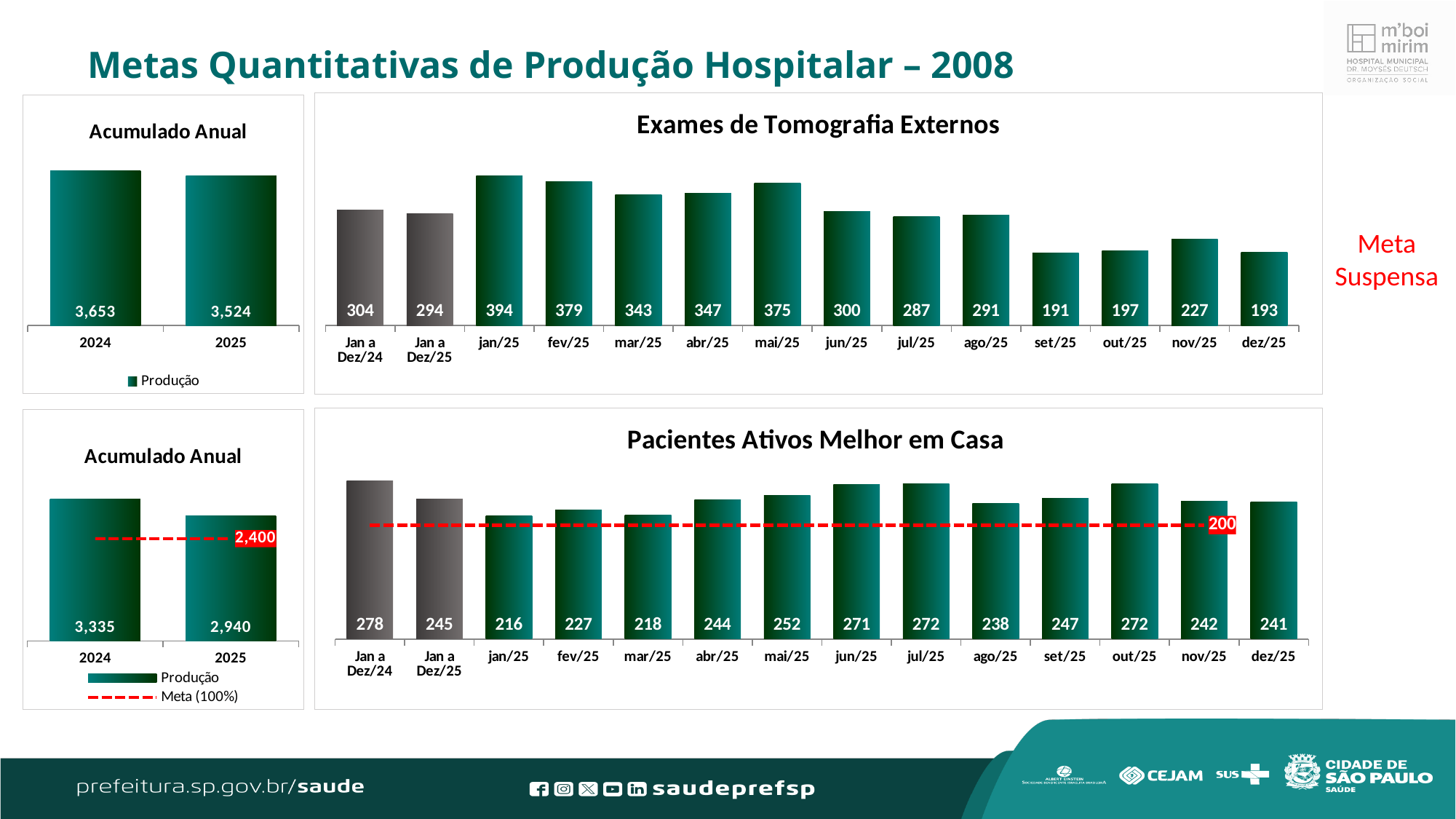
In the 'Pacientes Ativos Melhor em Casa' chart, which month of 2025 has the lowest value? jan/25 In the 'Pacientes Ativos Melhor em Casa' chart, what is the value for abr/25? 244 In the 'Pacientes Ativos Melhor em Casa' chart, what is the value of the Meta (100%) line? 200 In the 'Exames de Tomografia Externos' chart, which month of 2025 has the lowest value? set/25 How many series does the legend of the bottom-left 'Acumulado Anual' chart list? 2 What type of chart is 'Exames de Tomografia Externos'? Bar chart In the 'Pacientes Ativos Melhor em Casa' chart, which is larger, jun/25 or ago/25? jun/25 In the bottom-left 'Acumulado Anual' chart, what is the difference between 2024 and 2025? 395 In the 'Exames de Tomografia Externos' chart, what is the value for mai/25? 375 In the 'Exames de Tomografia Externos' chart, which month of 2025 has the highest value? jan/25 In the 'Exames de Tomografia Externos' chart, what is the difference between Jan a Dez/24 and Jan a Dez/25? 10 In the top-left 'Acumulado Anual' chart, what is the value for 2024? 3,653